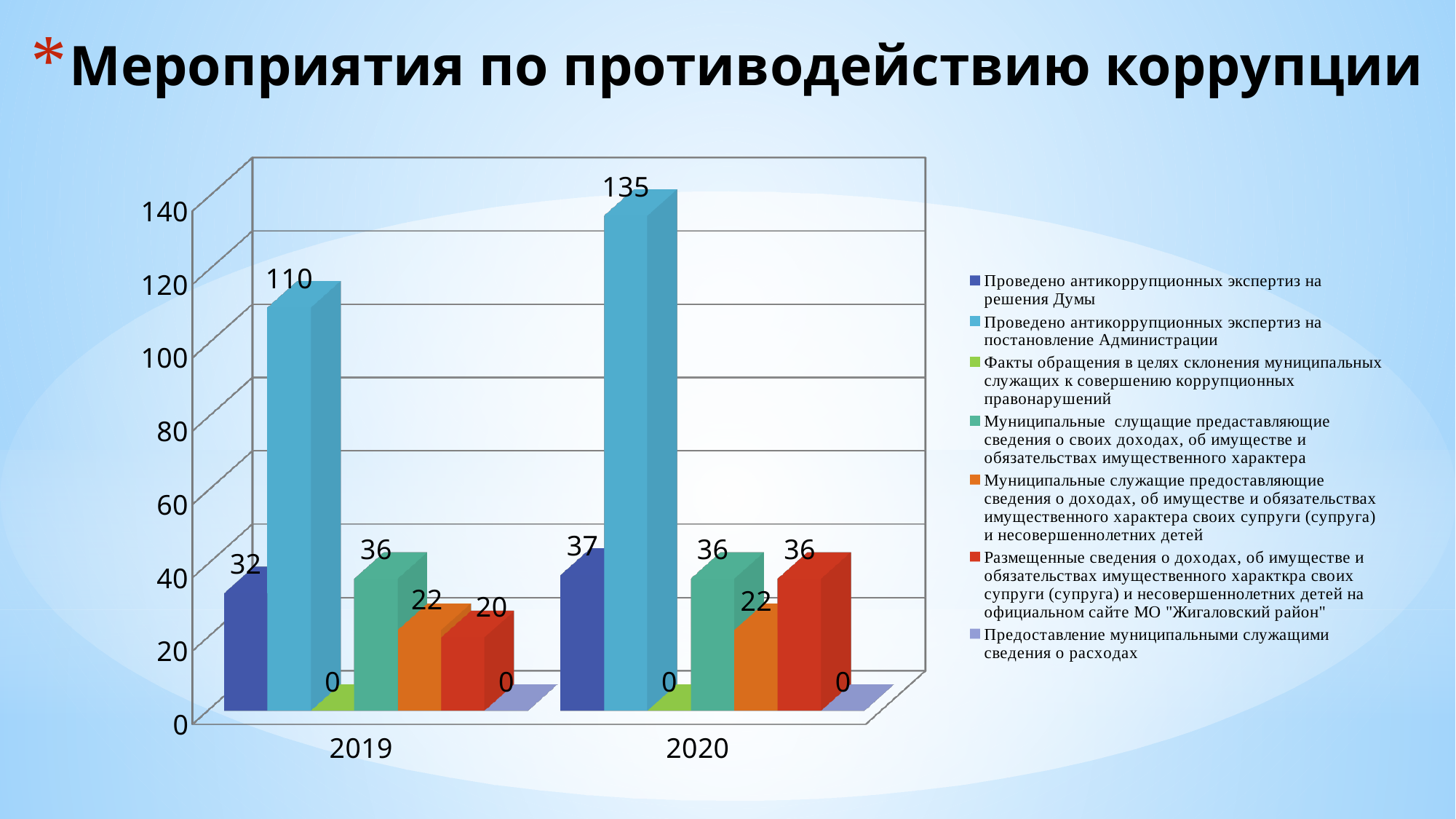
Which is larger: the 2019 or the 2020 value for 'Проведено антикоррупционных экспертиз на решения Думы'? 2020 What type of chart is shown on the slide? bar chart Which series has the highest value in 2020? Проведено антикоррупционных экспертиз на постановление Администрации What is the value for 'Предоставление муниципальными служащими сведения о расходах' in 2019? 0 How many categories are shown on the x axis? 2 What is the title of the chart slide? Мероприятия по противодействию коррупции What is the value for 'Проведено антикоррупционных экспертиз на постановление Администрации' in 2020? 135 What is the value for 'Проведено антикоррупционных экспертиз на постановление Администрации' in 2019? 110 How many series does the legend list? 7 What is the difference between the 2020 and 2019 values for 'Проведено антикоррупционных экспертиз на постановление Администрации'? 25 What is the value for 'Проведено антикоррупционных экспертиз на решения Думы' in 2019? 32 Does the value for 'Проведено антикоррупционных экспертиз на постановление Администрации' rise or fall from 2019 to 2020? rise